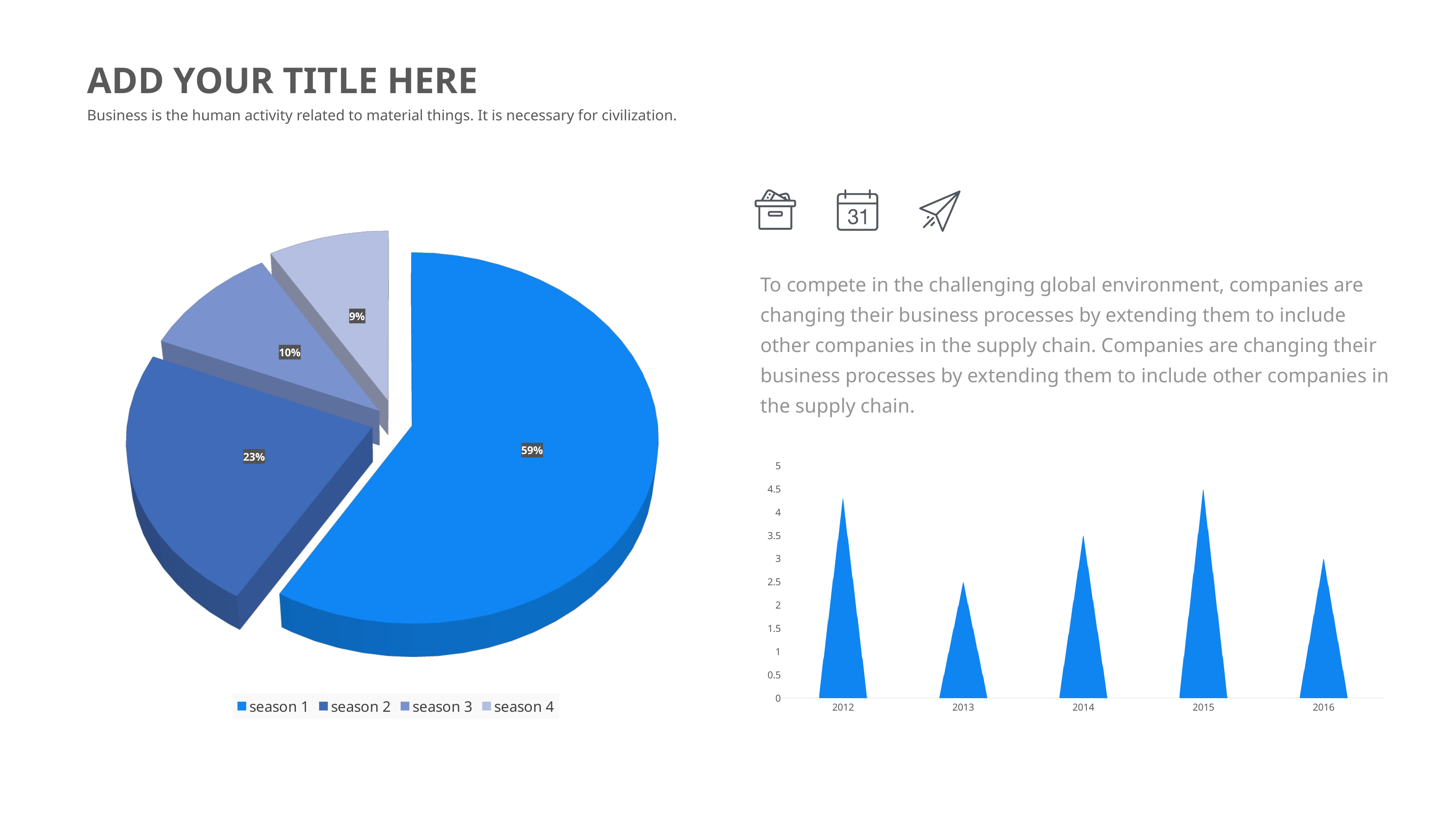
What kind of chart is shown on the left of the slide? pie chart In the pie chart on the left, which is larger, season 3 or season 4? season 3 In the pie chart on the left, what is the difference between the values for season 1 and season 2? 36% How many entries does the legend of the pie chart on the left list? 4 In the chart on the right, how many years are shown on the x axis? 5 In the pie chart on the left, which season has the largest slice? season 1 In the chart on the right, is the value for 2012 greater or less than 4? greater In the pie chart on the left, what is the value for season 2? 23% In the pie chart on the left, what is the value for season 1? 59% In the pie chart on the left, which season has the smallest slice? season 4 In the chart on the right, which year has the lowest value? 2013 In the pie chart on the left, what is the value for season 4? 9%